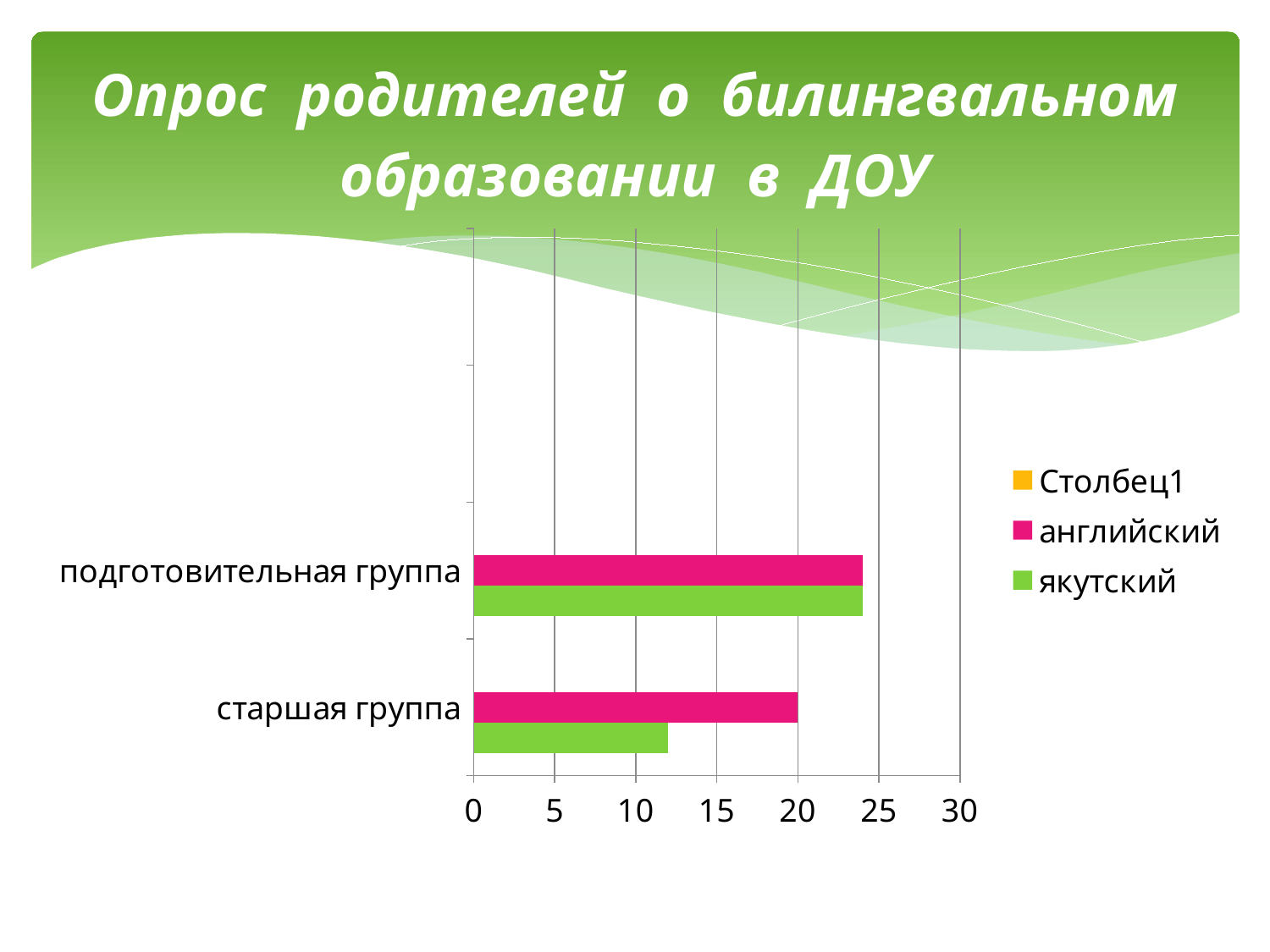
What kind of chart is shown on the slide? bar chart How many series does the legend list? 3 For the якутский series, which group has the higher value? подготовительная группа What is the value for английский in старшая группа? 20 How many groups (categories) are shown on the vertical axis? 2 Is the value for английский in подготовительная группа greater or less than 20? greater Is the value for якутский in старшая группа greater or less than 10? greater Which bar on the chart is the shortest? якутский in старшая группа Is the value for якутский in подготовительная группа greater or less than 25? less What colour represents the якутский series in the legend? green In старшая группа, which is larger: английский or якутский? английский